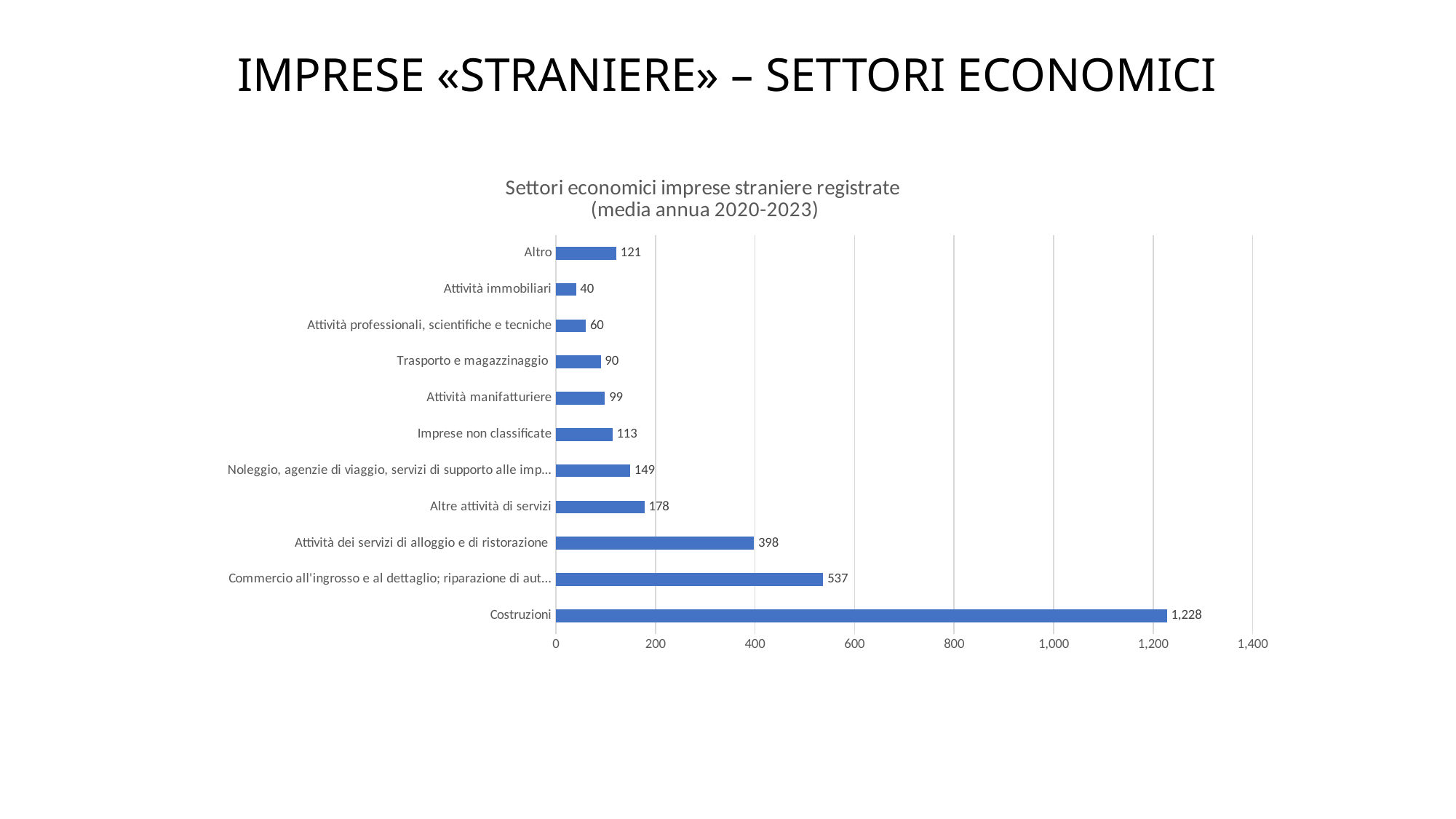
What is the value for Attività dei servizi di alloggio e di ristorazione? 398 How many categories are shown in the chart? 11 What is the value for Altro? 121 What kind of chart is shown on the slide? Bar chart What is the difference between the values for Costruzioni and Attività dei servizi di alloggio e di ristorazione? 830 Which is larger, the value for Attività manifatturiere or the value for Altro? Altro Which category has the lowest value? Attività immobiliari Which category has the highest value? Costruzioni What is the difference between the values for Altre attività di servizi and Imprese non classificate? 65 What is the title of the chart? Settori economici imprese straniere registrate (media annua 2020-2023) What is the value for Costruzioni? 1,228 What is the value for Trasporto e magazzinaggio? 90